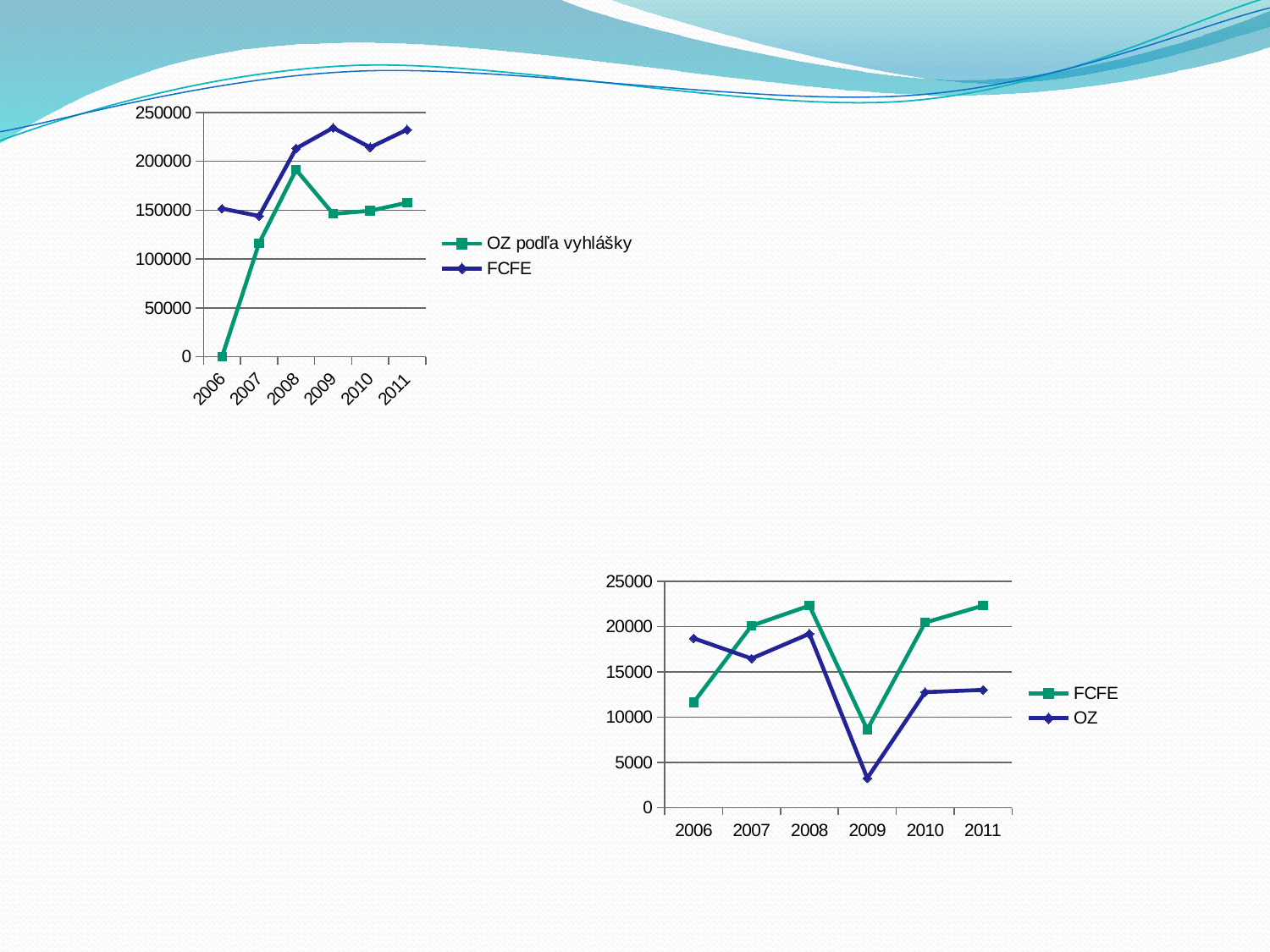
In the bottom-right chart, is the value for OZ in 2006 greater or less than 15000? greater In the top-left chart, how many years are shown on the x axis? 6 In the top-left chart, how many series does the legend list? 2 In the top-left chart, which series has the higher value in 2008, FCFE or OZ podľa vyhlášky? FCFE In the bottom-right chart, which series has the higher value in 2006, FCFE or OZ? OZ In the bottom-right chart, which series are listed in the legend? FCFE and OZ In the bottom-right chart, is the value for FCFE in 2009 greater or less than 10000? less In the top-left chart, is the value for OZ podľa vyhlášky in 2007 greater or less than 150000? less What kind of chart is the chart in the top-left of the slide? line chart In the bottom-right chart, in which year is the value for OZ lowest? 2009 In the top-left chart, in which year is the value for OZ podľa vyhlášky lowest? 2006